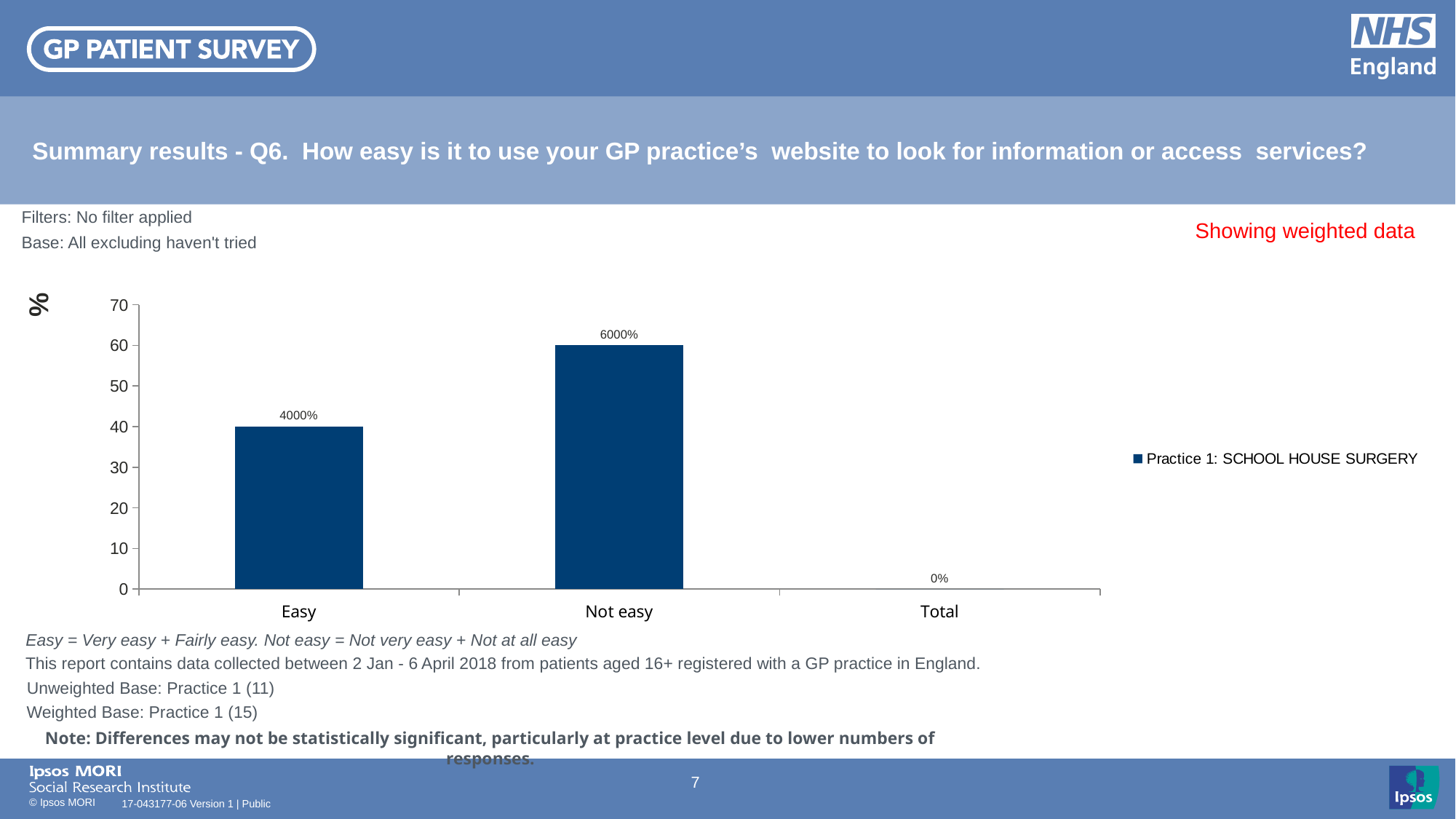
What is the data label shown for the Not easy bar? 6000% How many series does the legend list? 1 What is the data label shown for the Total category? 0% Which category has the lowest value? Total What kind of chart is shown on the slide? Bar chart How many categories are shown on the x axis? 3 Is the value for Not easy greater or less than 50 on the axis? greater Which is larger, the bar for Easy or the bar for Not easy? Not easy What is the name of the series shown in the legend? Practice 1: SCHOOL HOUSE SURGERY What is the data label shown for the Easy bar? 4000% Which category has the highest bar? Not easy Is the value for Easy greater or less than 50 on the axis? less